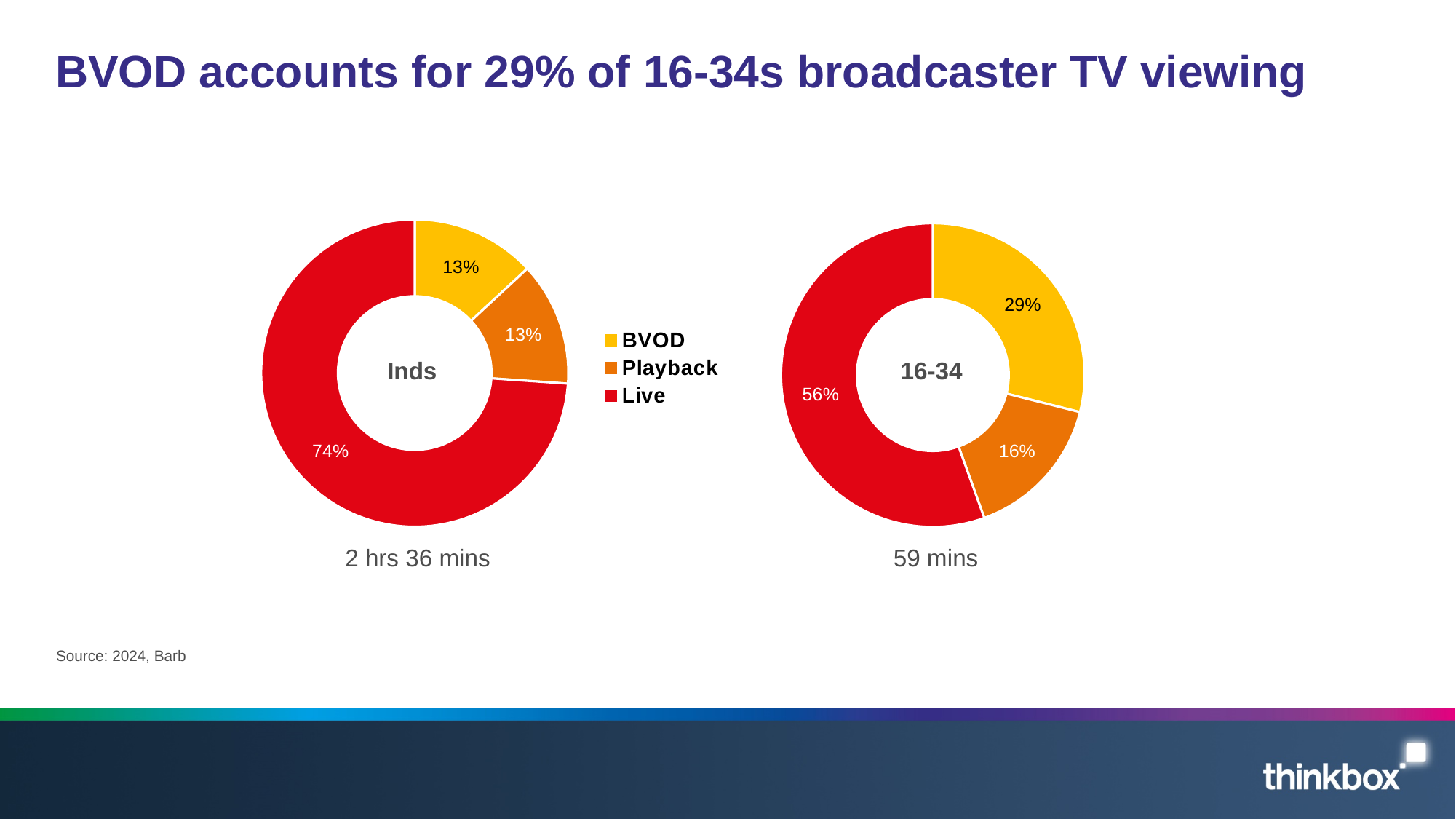
What is the difference between the Live share in the Inds chart and the Live share in the 16-34 chart? 18 percentage points In the 16-34 donut chart, what share of viewing is BVOD? 29% What total viewing time is shown beneath the 16-34 donut chart? 59 mins In the Inds donut chart, what share of viewing is BVOD? 13% In the Inds donut chart, what share of viewing is Live? 74% What type of chart is used to show the Inds and 16-34 viewing splits? Donut (pie) chart In the 16-34 donut chart, which category has the smallest share? Playback How many categories does the legend list for the donut charts? 3 In the 16-34 donut chart, which category has the largest share? Live Is the BVOD share larger in the Inds chart or the 16-34 chart? 16-34 In the 16-34 donut chart, what share of viewing is Playback? 16% Which colour represents Playback in the legend? Orange